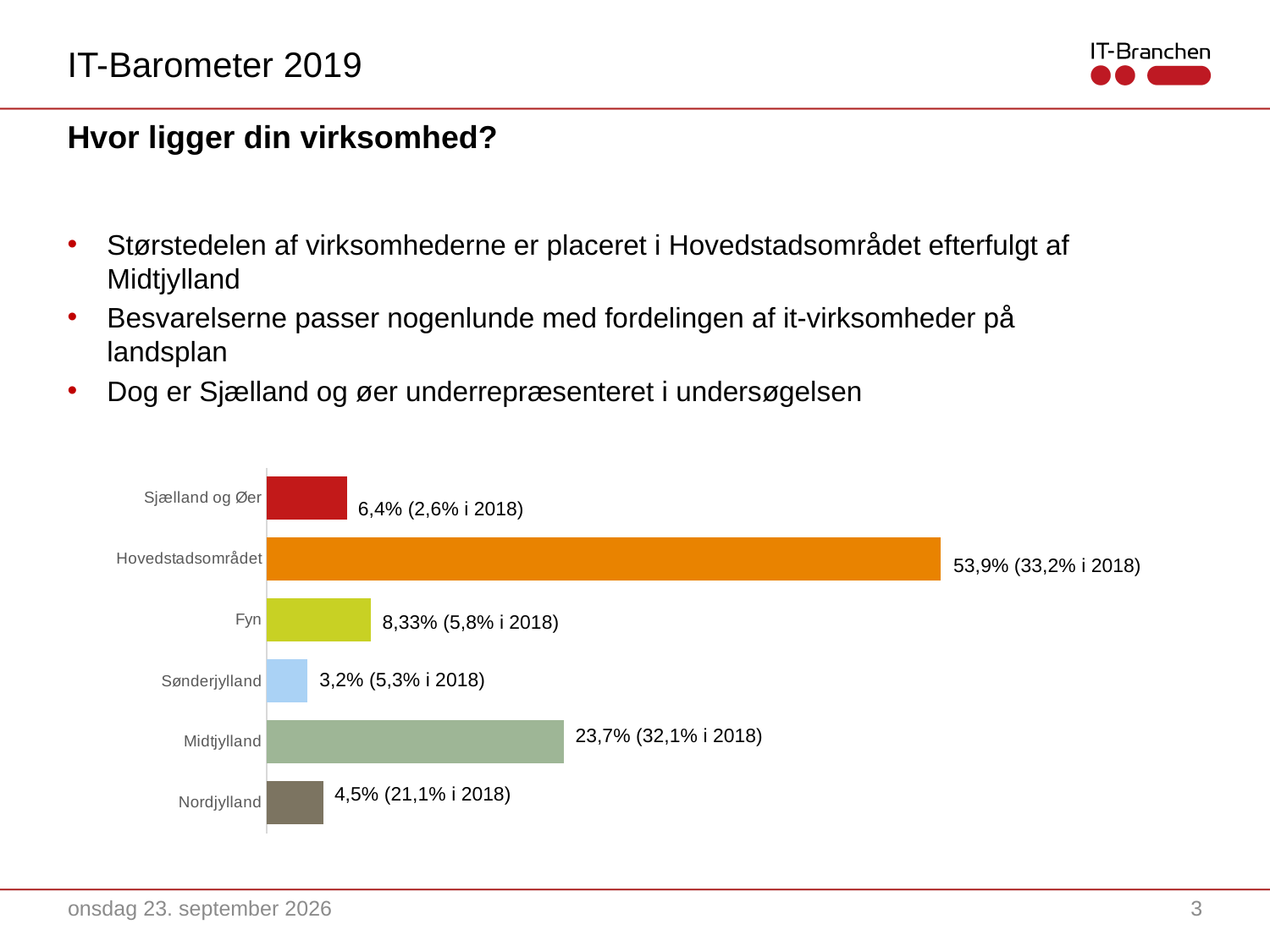
What is the value for Fyn? 8,33% Which is larger, the value for Sjælland og Øer or the value for Nordjylland? Sjælland og Øer What is the value for Midtjylland? 23,7% What colour is the bar for Hovedstadsområdet? Orange What kind of chart is shown on the slide? Bar chart What is the difference between the 2019 and 2018 values for Sjælland og Øer? 3,8% How many regions are shown in the chart? 6 Which region has the lowest value? Sønderjylland What is the value for Hovedstadsområdet? 53,9% What was the 2018 value shown for Nordjylland? 21,1% Which region has the highest value? Hovedstadsområdet What is the difference between the values for Hovedstadsområdet and Midtjylland? 30,2%